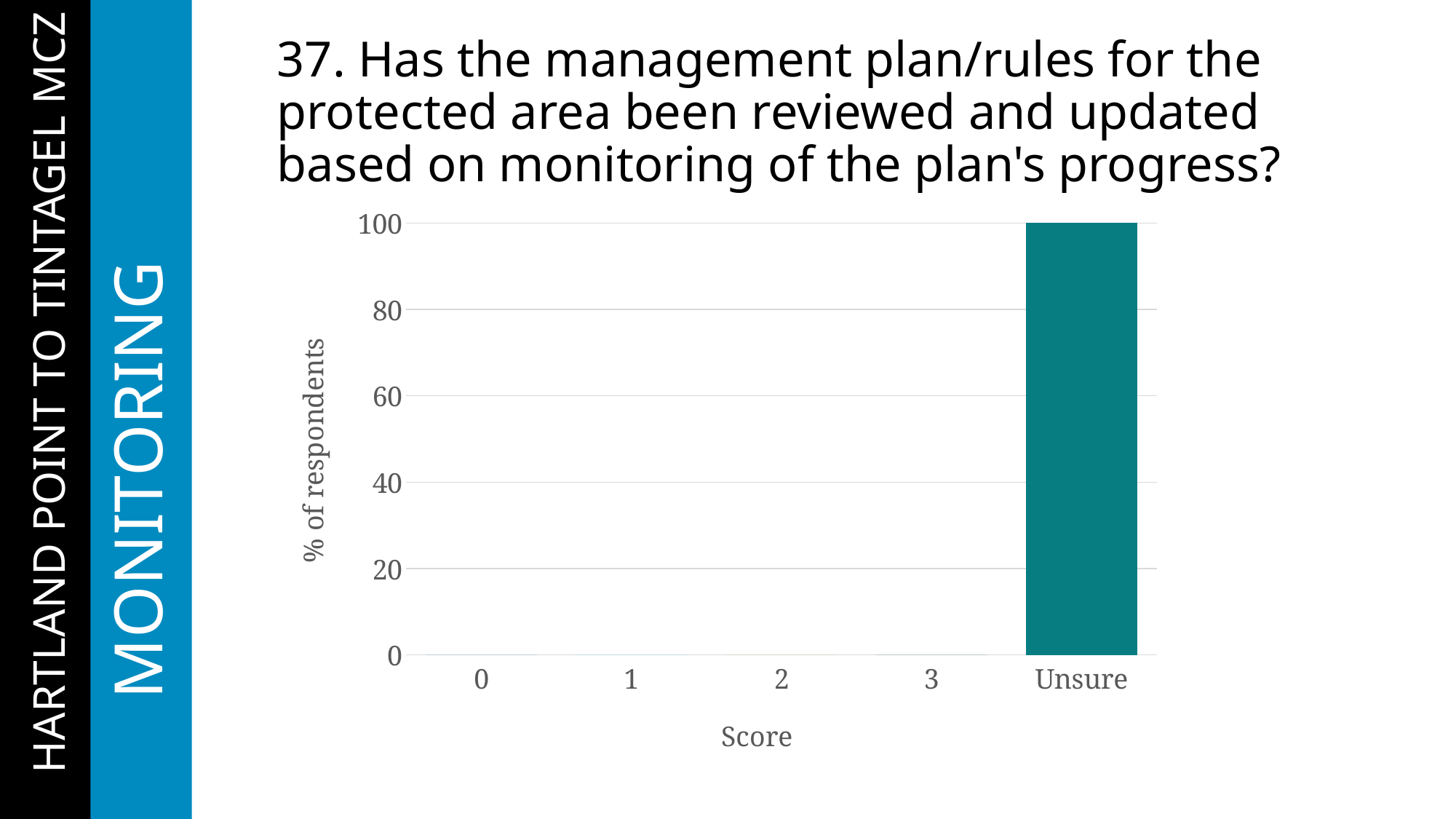
Is the value for Unsure greater or less than 80? greater What is the highest value shown on the y axis? 100 What is the label of the y axis? % of respondents How many categories are shown on the x axis of the chart? 5 What kind of chart is shown on the slide? bar chart How many categories have a visible bar in the chart? 1 What is the label of the x axis? Score Is the value for score 2 greater or less than 20? less What is the value for the Unsure category? 100 Which is larger, the value for score 3 or the value for Unsure? Unsure Which category has the highest value in the chart? Unsure